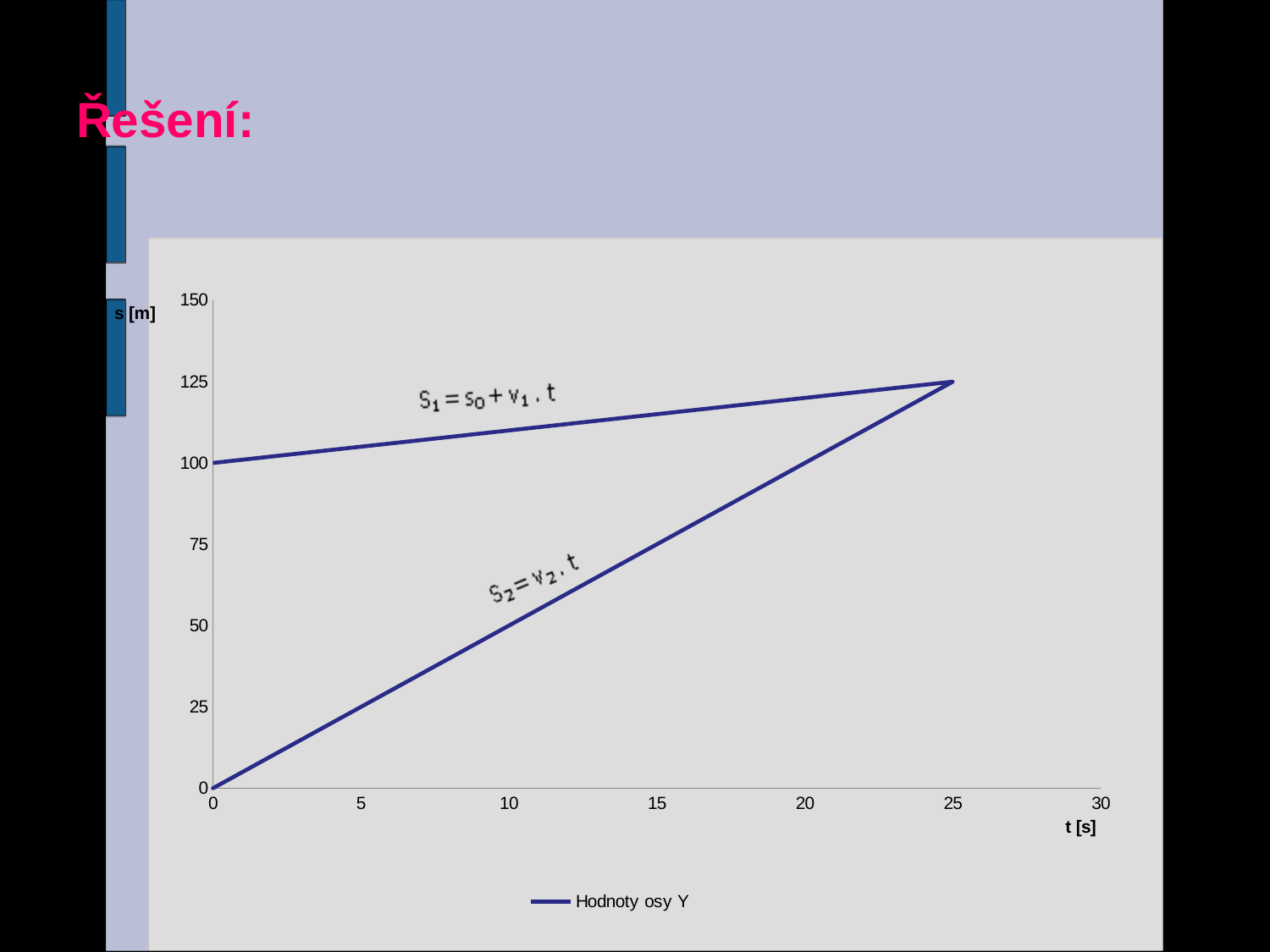
Is the value of the S2 line at t = 10 greater or less than 75? less At what value of t do the S1 and S2 lines meet? 25 How many series does the legend list? 1 What is the value of the S1 line at t = 0? 100 What is the legend entry shown below the chart? Hodnoty osy Y What is the label of the horizontal axis? t [s] What is the difference between the S1 and S2 values at t = 0? 100 At t = 10, which line has the higher value, S1 or S2? S1 Does the S2 line rise or fall as t increases from 0 to 25? rise What kind of chart is shown on the slide? line chart What is the value of s where the S1 and S2 lines meet? 125 What is the value of the S2 line at t = 0? 0